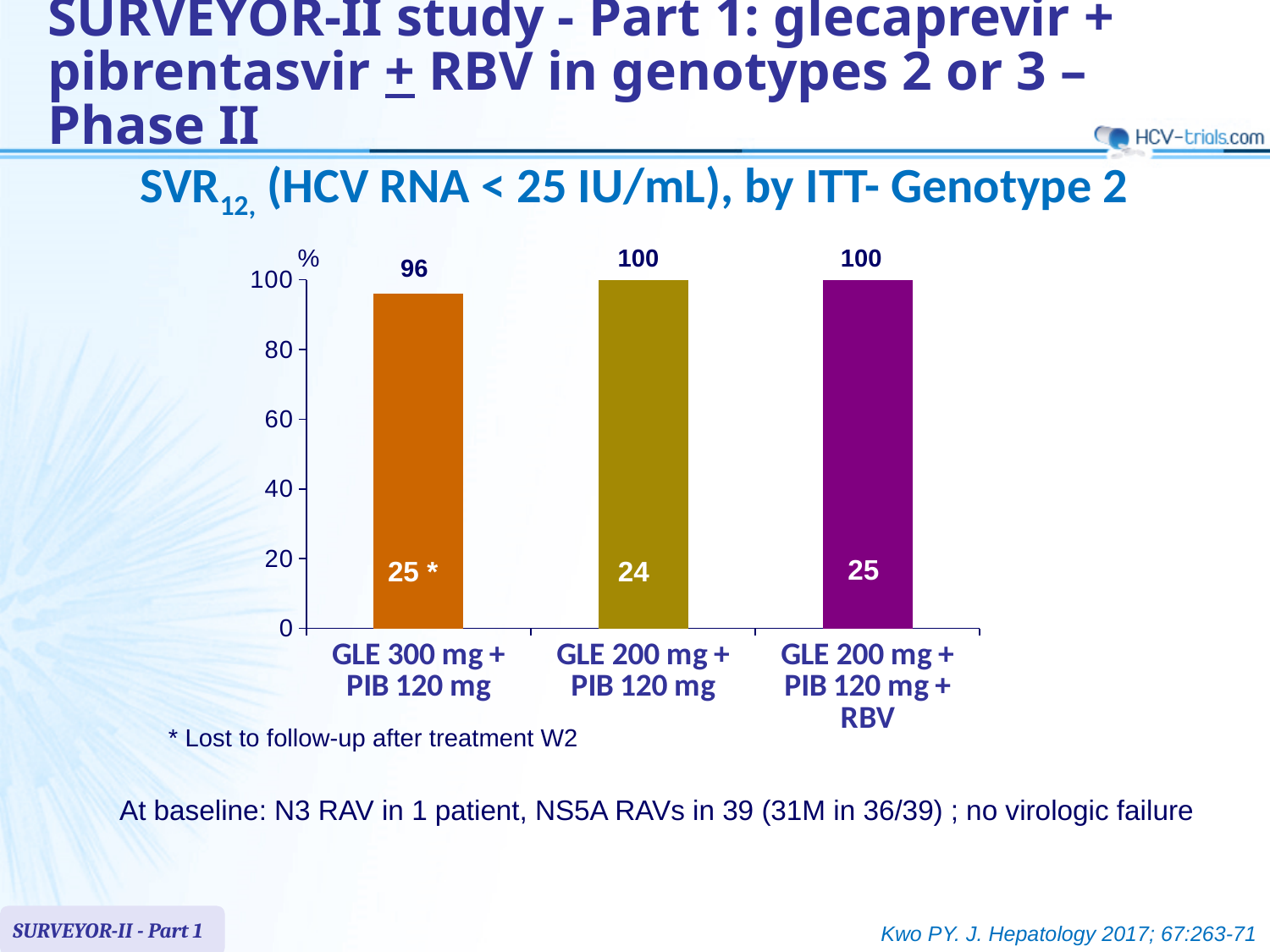
What is the SVR12 value for GLE 200 mg + PIB 120 mg + RBV? 100 What kind of chart is shown on the slide? Bar chart What number is printed inside the bar for GLE 200 mg + PIB 120 mg + RBV? 25 What unit is shown on the y axis of the chart? % What is the SVR12 value for GLE 300 mg + PIB 120 mg? 96 Is the value for GLE 300 mg + PIB 120 mg greater or less than 80? greater What is the difference between the SVR12 values for GLE 200 mg + PIB 120 mg and GLE 300 mg + PIB 120 mg? 4 Which has a higher SVR12 value: GLE 300 mg + PIB 120 mg or GLE 200 mg + PIB 120 mg + RBV? GLE 200 mg + PIB 120 mg + RBV Which treatment arm has the lowest SVR12 value? GLE 300 mg + PIB 120 mg What number is printed inside the bar for GLE 200 mg + PIB 120 mg? 24 What is the SVR12 value for GLE 200 mg + PIB 120 mg? 100 How many treatment arms are shown in the chart? 3